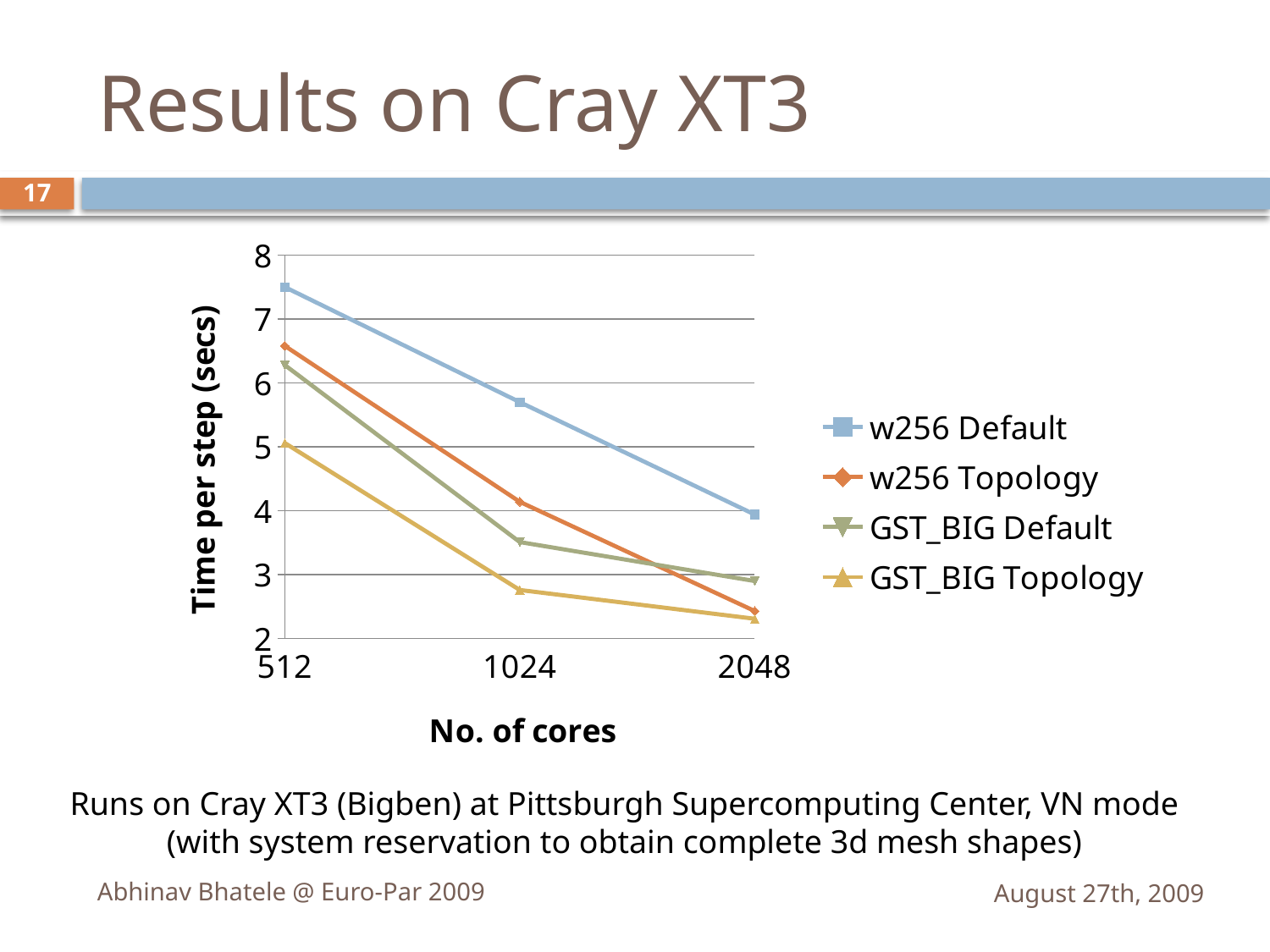
What is the label of the y axis? Time per step (secs) What kind of chart is shown on the slide? line chart At 2048 cores, which has the larger time per step: GST_BIG Default or w256 Topology? GST_BIG Default How many core counts are plotted along the x axis? 3 How many series does the legend list? 4 Which series has the highest time per step at 2048 cores? w256 Default Is the time per step for w256 Default at 512 cores greater or less than 7? greater Which series has the lowest time per step at 512 cores? GST_BIG Topology Does the time per step for w256 Default rise or fall as the number of cores increases? fall Is the time per step for GST_BIG Topology at 1024 cores greater or less than 3? less Which series has the highest time per step at 512 cores? w256 Default